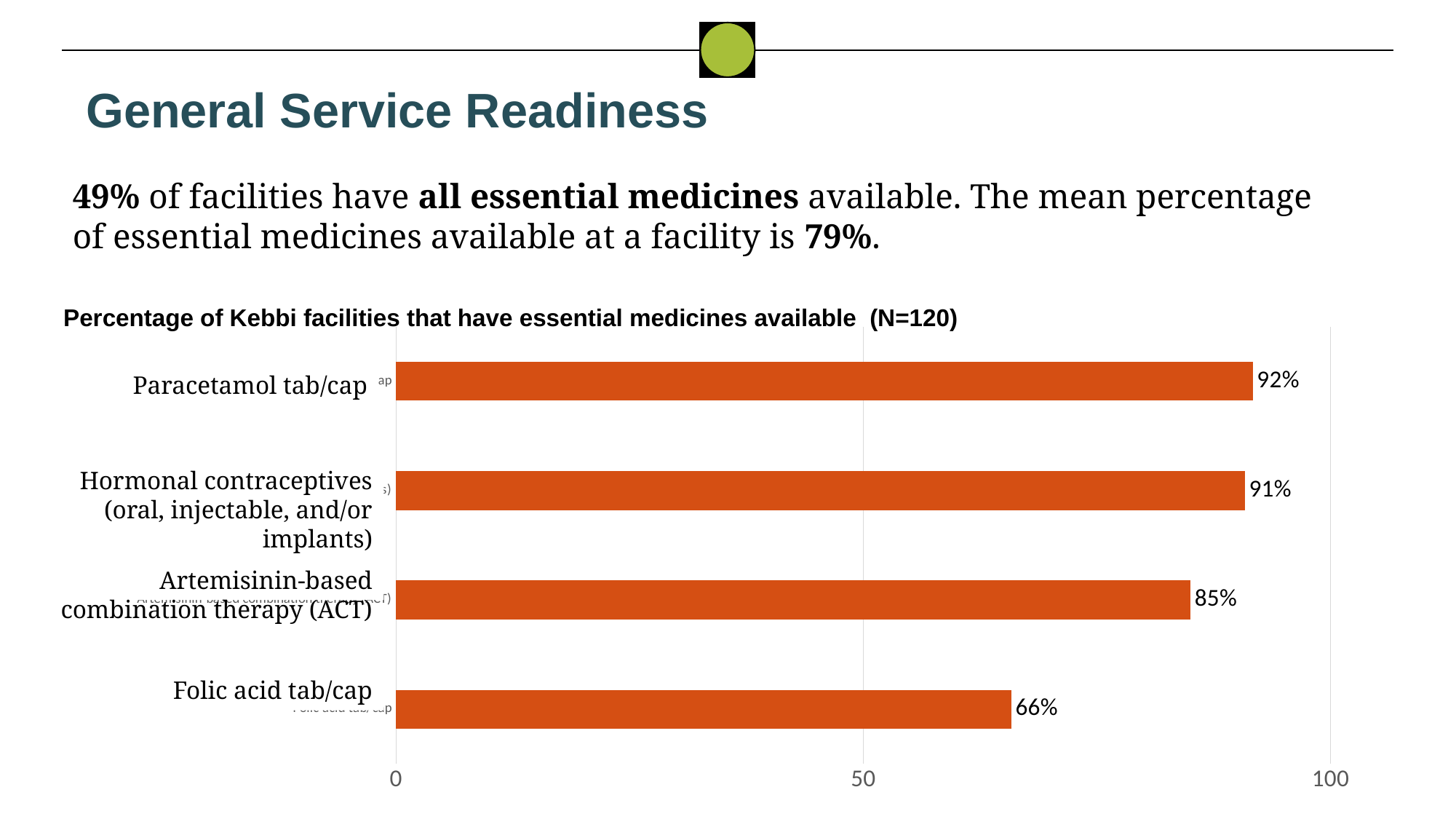
What is the sample size (N) stated in the chart title? N=120 What is the value shown for Artemisinin-based combination therapy (ACT)? 85% What percentage of Kebbi facilities have Paracetamol tab/cap available? 92% What percentage of facilities have Folic acid tab/cap available? 66% Which essential medicine has the highest availability in the chart? Paracetamol tab/cap What is the difference in percentage points between Paracetamol tab/cap and Folic acid tab/cap? 26 How many medicine categories are shown in the chart? 4 What is the value shown for Hormonal contraceptives (oral, injectable, and/or implants)? 91% Which essential medicine has the lowest availability in the chart? Folic acid tab/cap Which has a higher availability: Artemisinin-based combination therapy (ACT) or Folic acid tab/cap? Artemisinin-based combination therapy (ACT) Is the value for Folic acid tab/cap greater or less than 50? greater What type of chart is shown on the slide? Bar chart